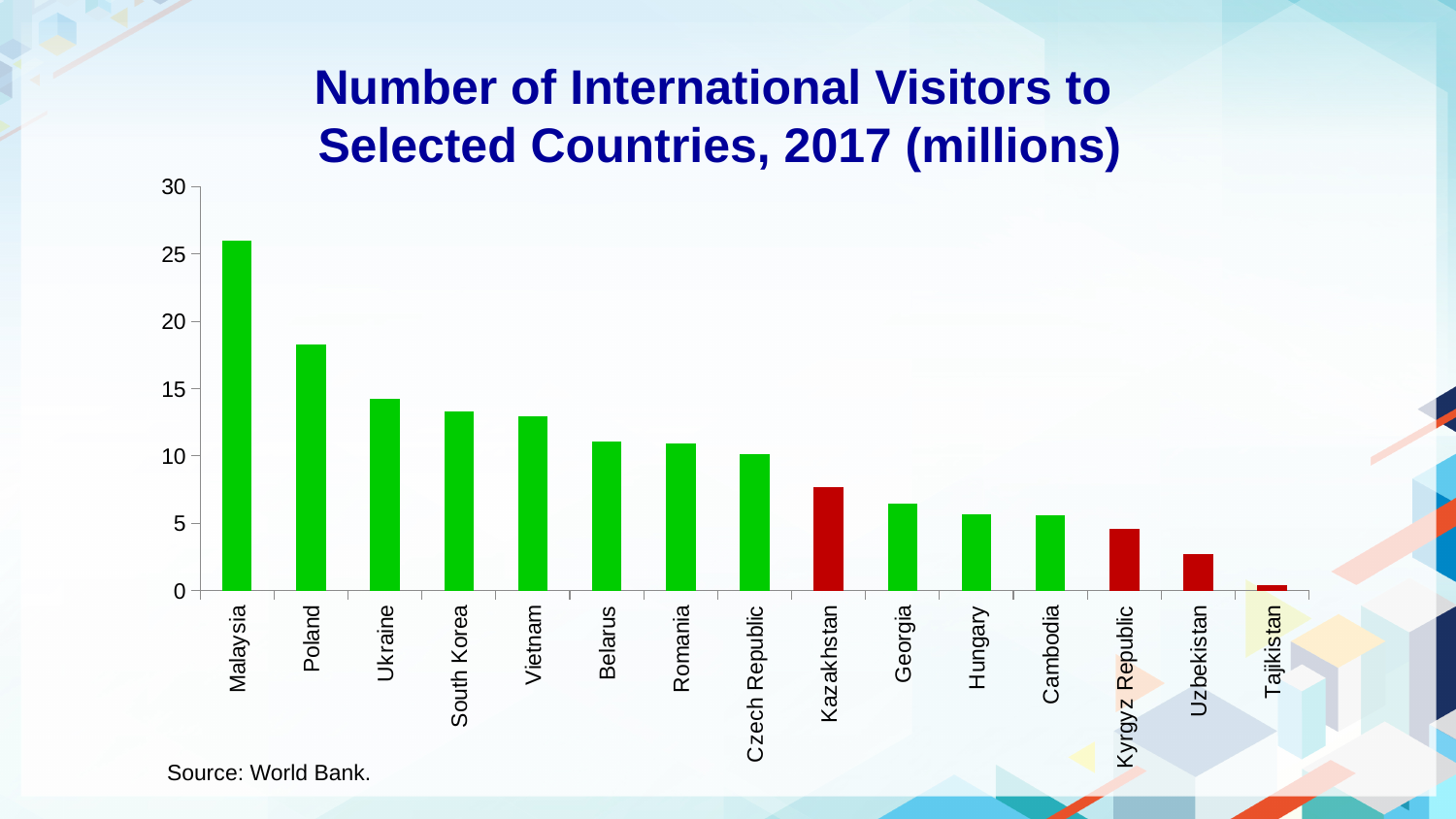
How many bars in the chart are coloured red? 4 Which has more international visitors, Vietnam or Belarus? Vietnam Do the bar values rise or fall from left to right across the chart? Fall Is the value for Uzbekistan greater or less than 5? less Is the value for Malaysia greater or less than 25? greater How many countries are shown in the chart? 15 Is the value for Poland greater or less than 20? less Which country has the highest number of international visitors in the chart? Malaysia Which has more international visitors, Kazakhstan or Georgia? Kazakhstan Which country has the lowest number of international visitors in the chart? Tajikistan What kind of chart is shown on the slide? Bar chart